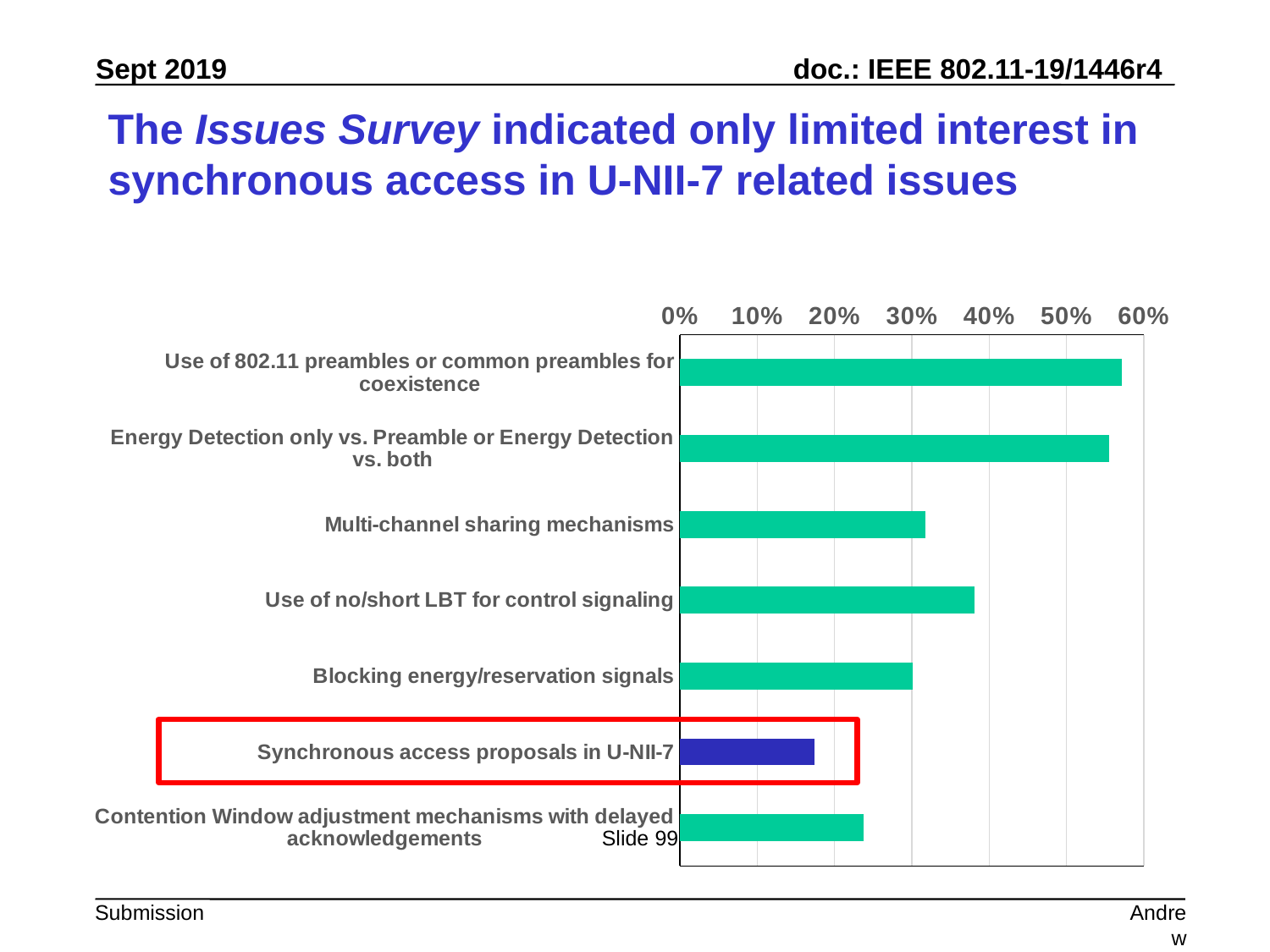
How many categories are plotted in the chart? 7 Which category has the lowest value in the chart? Synchronous access proposals in U-NII-7 Which is larger: the value for Use of no/short LBT for control signaling or the value for Multi-channel sharing mechanisms? Use of no/short LBT for control signaling What is the highest value shown on the chart's percentage axis? 60% Is the value for Energy Detection only vs. Preamble or Energy Detection vs. both greater or less than 50%? greater Is the value for Synchronous access proposals in U-NII-7 greater or less than 20%? less Which category's bar is drawn in a different colour (dark blue) and outlined with a red box? Synchronous access proposals in U-NII-7 Is the value for Use of 802.11 preambles or common preambles for coexistence greater or less than 50%? greater What kind of chart is shown on the slide? bar chart Which is larger: the value for Synchronous access proposals in U-NII-7 or the value for Contention Window adjustment mechanisms with delayed acknowledgements? Contention Window adjustment mechanisms with delayed acknowledgements